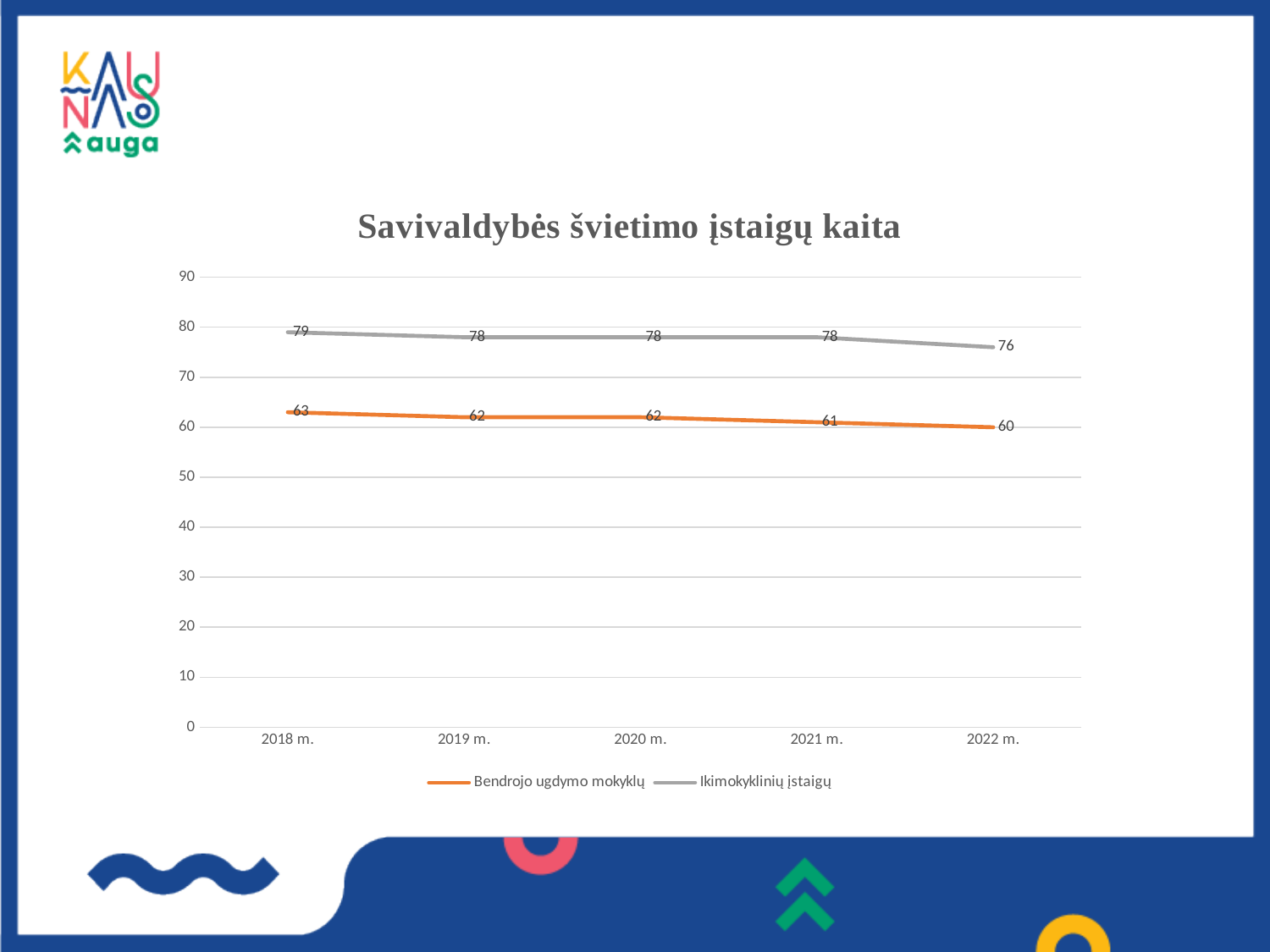
In which year is the value for Bendrojo ugdymo mokyklų highest? 2018 m. Does the value for Bendrojo ugdymo mokyklų rise or fall from 2018 m. to 2022 m.? Fall What is the value for Bendrojo ugdymo mokyklų in 2021 m.? 61 What kind of chart is shown? Line chart What is the value for Bendrojo ugdymo mokyklų in 2022 m.? 60 What is the value for Ikimokyklinių įstaigų in 2018 m.? 79 How many series does the legend list? 2 Which series has the larger value in 2019 m., Bendrojo ugdymo mokyklų or Ikimokyklinių įstaigų? Ikimokyklinių įstaigų What is the difference between Ikimokyklinių įstaigų and Bendrojo ugdymo mokyklų in 2020 m.? 16 In which year is the value for Ikimokyklinių įstaigų lowest? 2022 m. How many years are shown on the x axis? 5 What is the value for Ikimokyklinių įstaigų in 2022 m.? 76